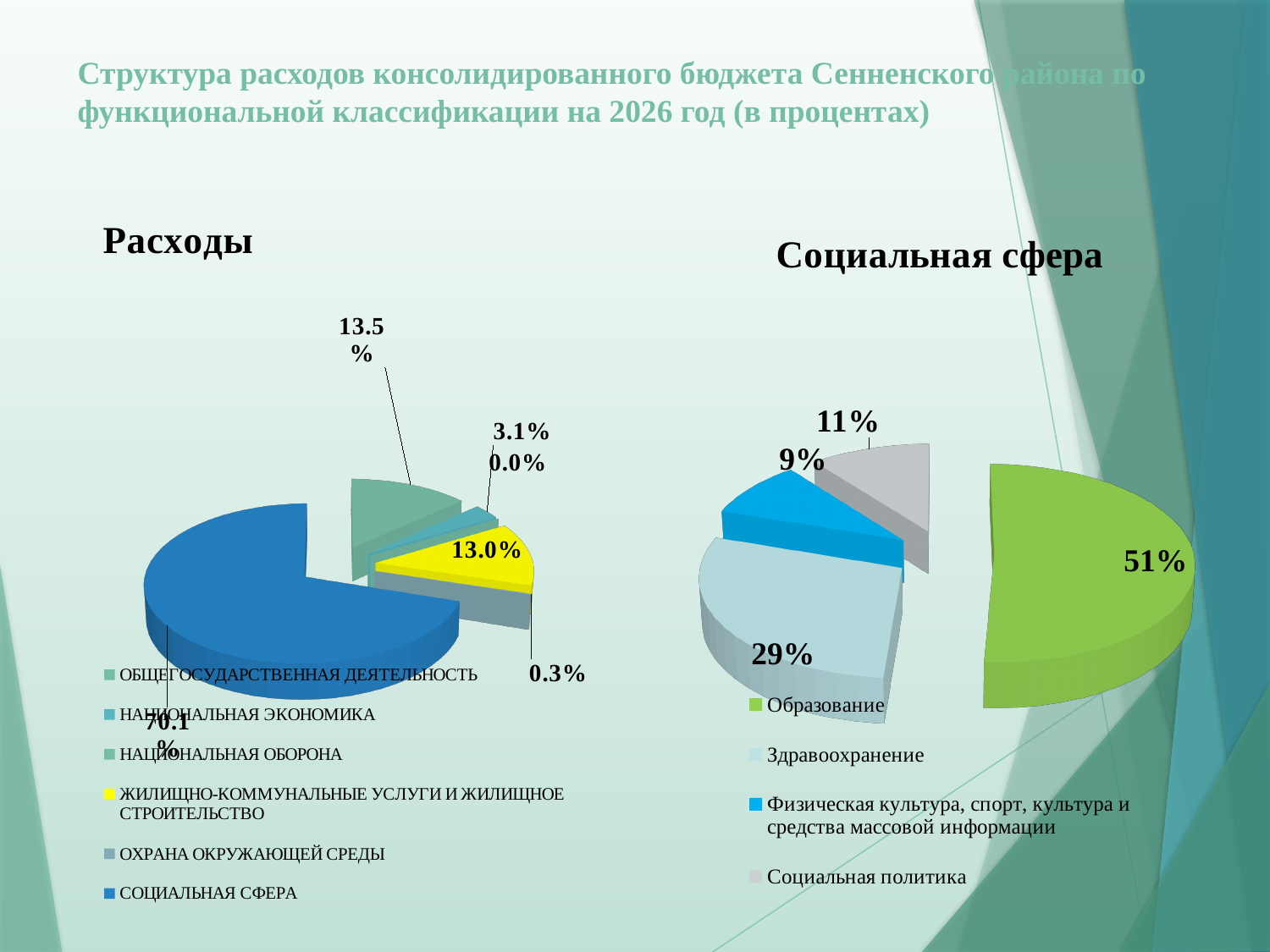
On the "Расходы" chart, how many categories does the legend list? 6 On the "Расходы" chart, which is larger: ОБЩЕГОСУДАРСТВЕННАЯ ДЕЯТЕЛЬНОСТЬ or НАЦИОНАЛЬНАЯ ЭКОНОМИКА? ОБЩЕГОСУДАРСТВЕННАЯ ДЕЯТЕЛЬНОСТЬ On the "Социальная сфера" chart, which category has the smallest share? Физическая культура, спорт, культура и средства массовой информации On the "Социальная сфера" chart, what share does Социальная политика have? 11% On the "Социальная сфера" chart, how many categories does the legend list? 4 On the "Расходы" chart, what share does ЖИЛИЩНО-КОММУНАЛЬНЫЕ УСЛУГИ И ЖИЛИЩНОЕ СТРОИТЕЛЬСТВО have? 13.0% On the "Расходы" chart, what share does СОЦИАЛЬНАЯ СФЕРА have? 70.1% On the "Социальная сфера" chart, what is the difference between the shares of Образование and Здравоохранение? 22% On the "Социальная сфера" chart, what share does Образование have? 51% On the "Расходы" chart, which category has the largest share? СОЦИАЛЬНАЯ СФЕРА On the "Социальная сфера" chart, what share does Здравоохранение have? 29% What type of chart is the "Расходы" chart? Pie chart